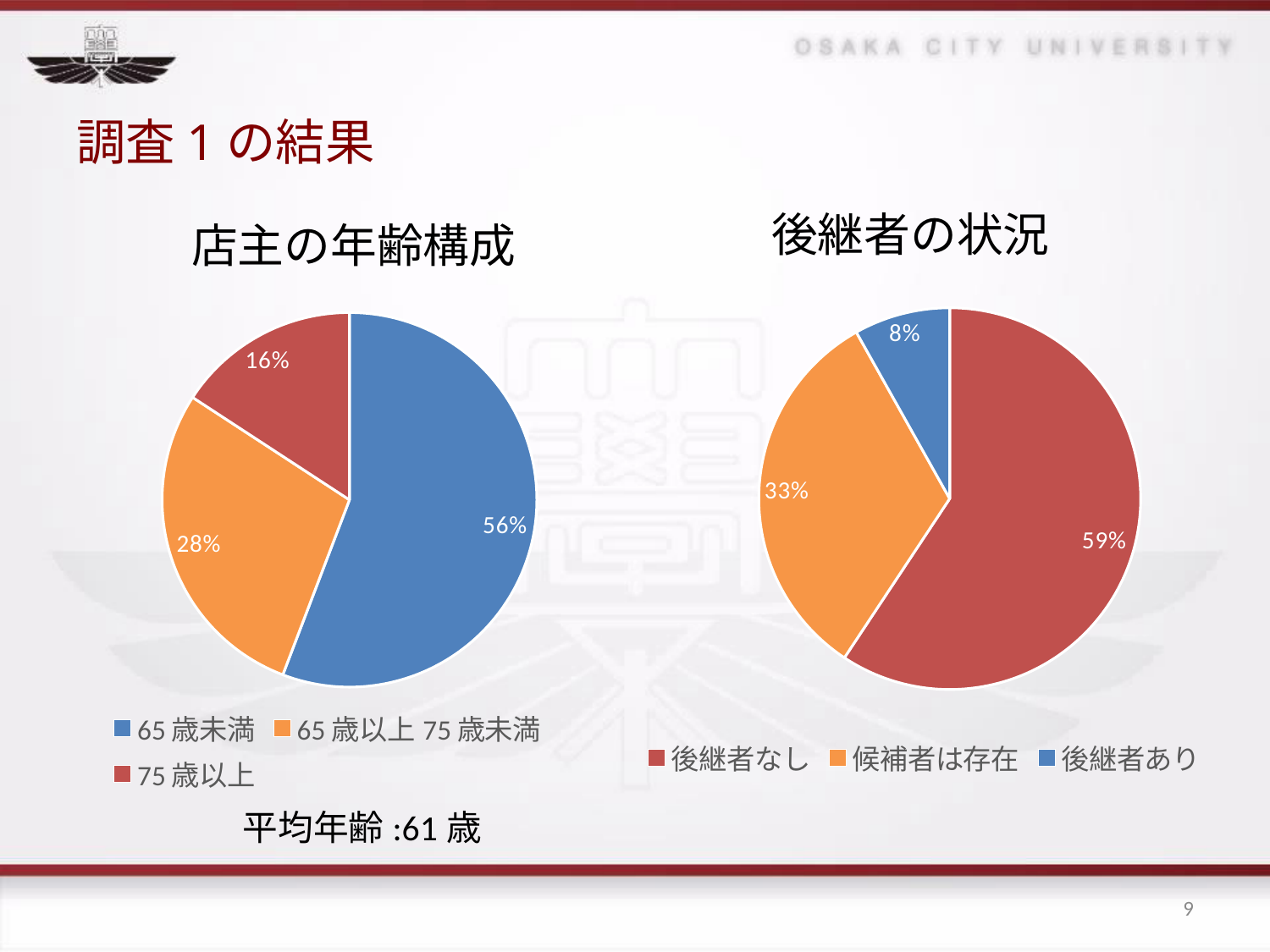
In the 後継者の状況 chart, what share is 候補者は存在? 33% What type of chart is the 後継者の状況 chart? Pie chart In the 後継者の状況 chart, what colour is the 後継者なし slice? Red In the 後継者の状況 chart, which category has the smallest share? 後継者あり In the 後継者の状況 chart, what share is 後継者あり? 8% In the 店主の年齢構成 chart, how many categories are shown? 3 In the 店主の年齢構成 chart, what share is 65 歳未満? 56% In the 店主の年齢構成 chart, what share is 75 歳以上? 16% In the 店主の年齢構成 chart, which category has the largest share? 65 歳未満 In the 後継者の状況 chart, what is the difference between 後継者なし and 後継者あり? 51% In the 後継者の状況 chart, which is larger: 後継者なし or 候補者は存在? 後継者なし In the 店主の年齢構成 chart, what is the difference between the 65 歳以上 75 歳未満 share and the 75 歳以上 share? 12%